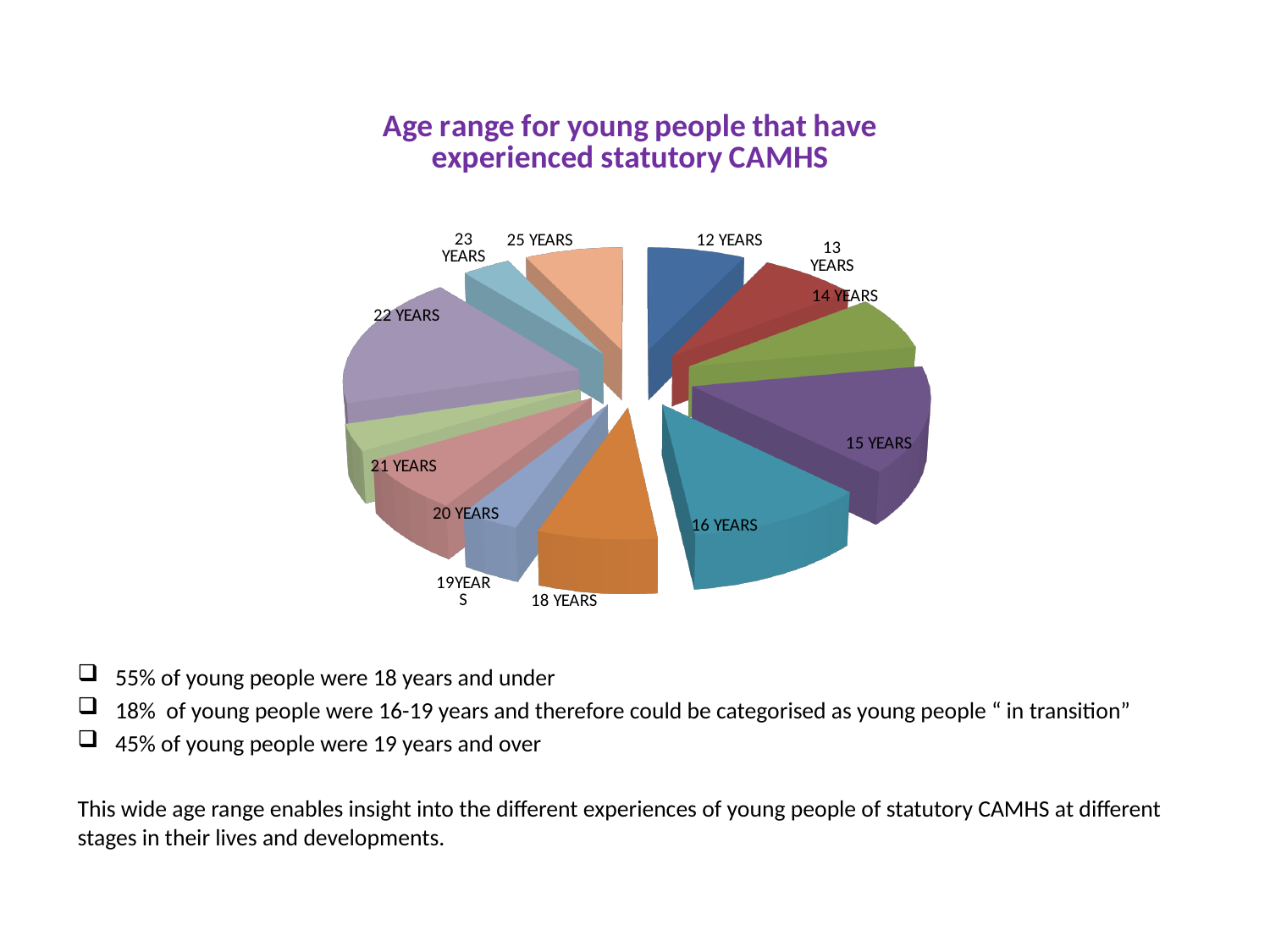
What colour is the 18 YEARS slice of the pie chart? orange What is the title of the chart? Age range for young people that have experienced statutory CAMHS Which slice is larger, 22 YEARS or 19 YEARS? 22 YEARS Is there a slice labelled 17 YEARS in the pie chart? No What kind of chart is shown on the slide? pie chart How many age categories (slices) does the pie chart show? 12 Which slice is larger, 16 YEARS or 23 YEARS? 16 YEARS Which slice is larger, 18 YEARS or 21 YEARS? 18 YEARS